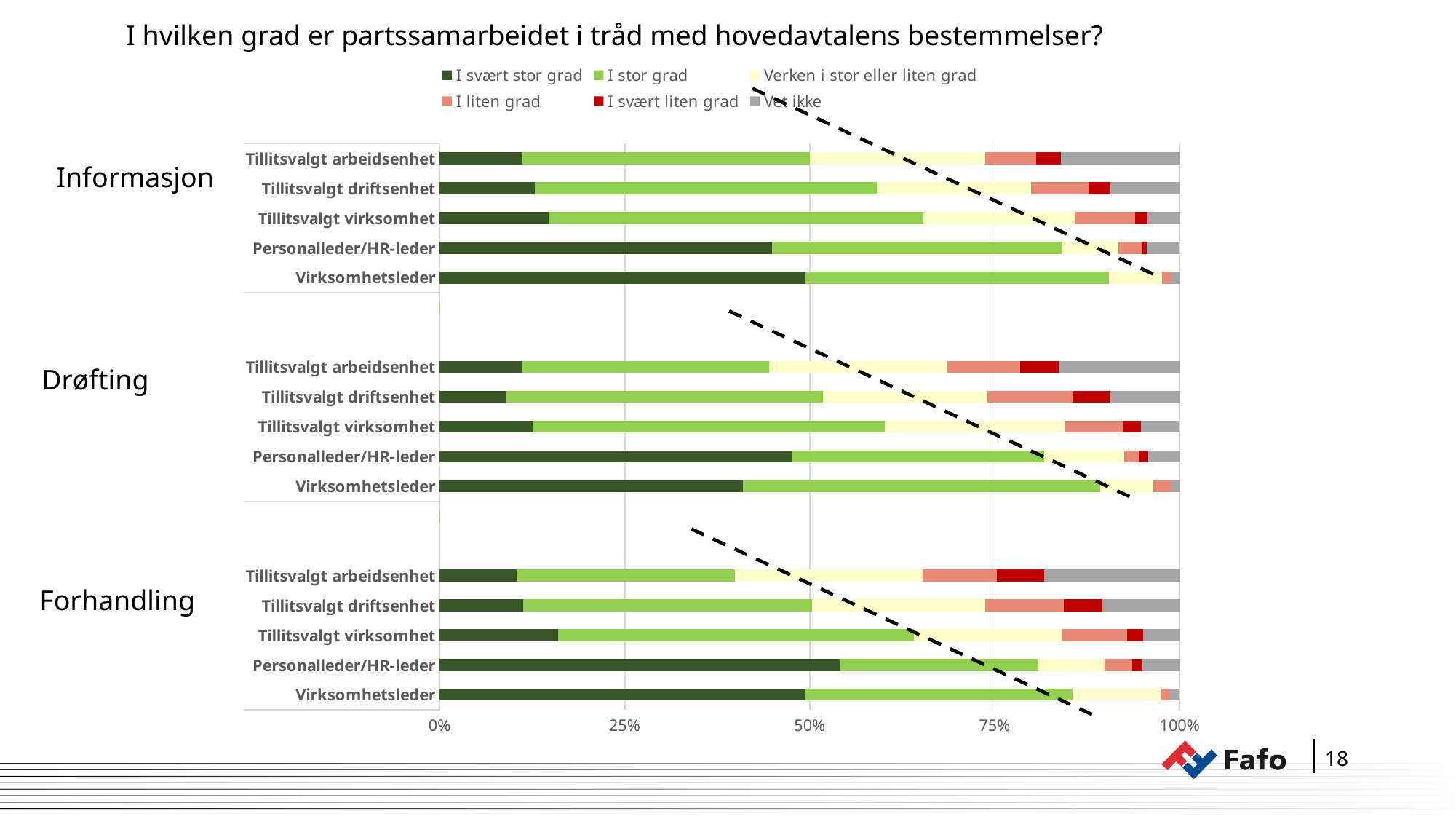
In the Forhandling group, is the 'I svært stor grad' share for Personalleder/HR-leder greater or less than 50%? greater What is the title of the chart? I hvilken grad er partssamarbeidet i tråd med hovedavtalens bestemmelser? In the Forhandling group, which has the larger 'Vet ikke' segment: Tillitsvalgt arbeidsenhet or Virksomhetsleder? Tillitsvalgt arbeidsenhet In the Drøfting group, is the 'I svært stor grad' share for Tillitsvalgt driftsenhet greater or less than 25%? less What is the highest value shown on the x axis? 100% What kind of chart is shown on the slide? Stacked bar chart In the Informasjon group, is the 'I svært stor grad' share for Personalleder/HR-leder greater or less than 50%? less In the Drøfting group, which category has the largest 'I svært stor grad' segment? Personalleder/HR-leder How many groups of bars (Informasjon, Drøfting, Forhandling) does the chart contain? 3 How many series does the legend list? 6 In the Informasjon group, which has the larger 'I svært stor grad' segment: Tillitsvalgt virksomhet or Tillitsvalgt arbeidsenhet? Tillitsvalgt virksomhet How many categories (bars) are shown in the Informasjon group? 5